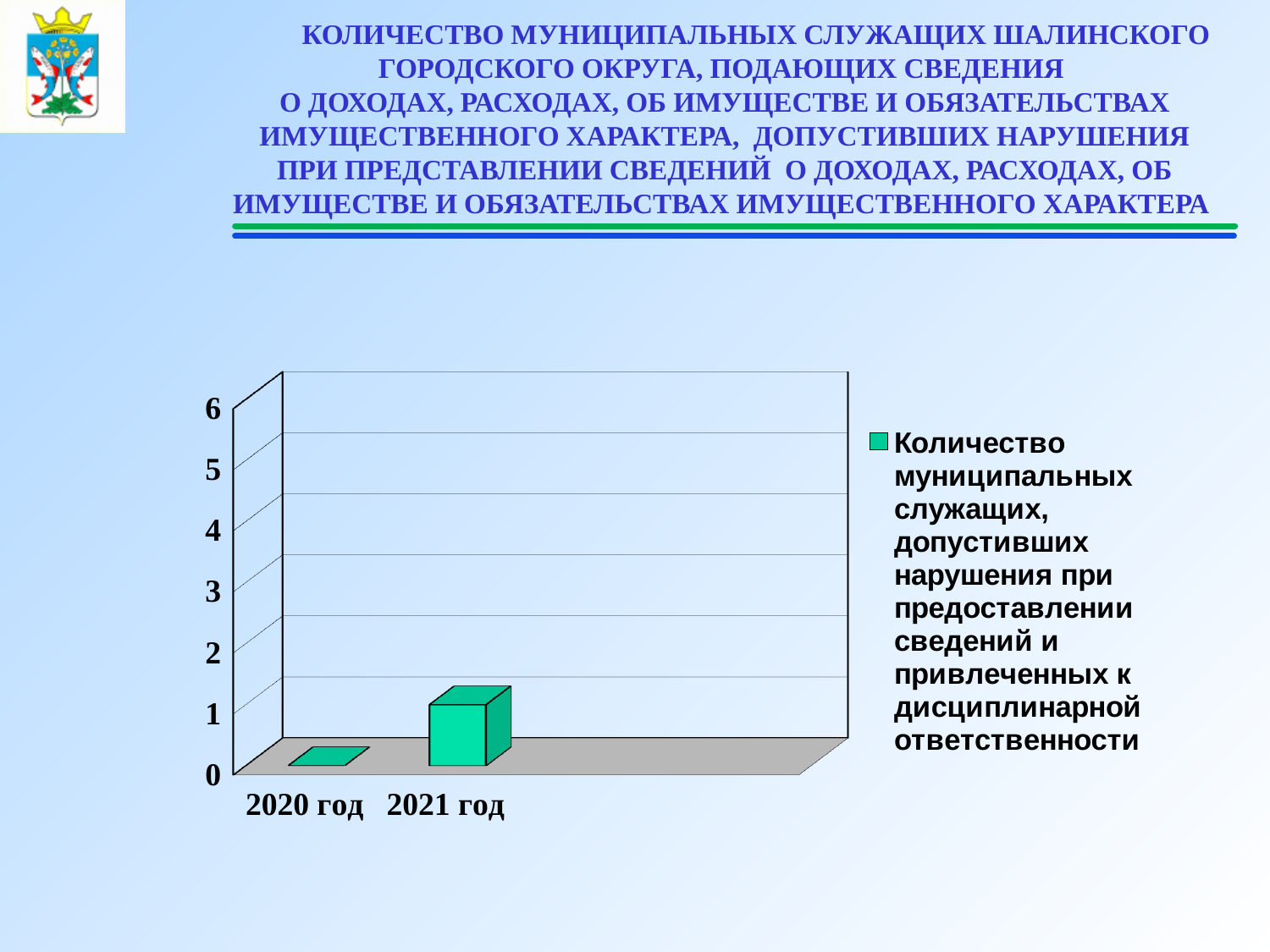
Is the value for 2020 год greater or less than 1? less What is the value for 2020 год in the chart? 0 Is the value for 2021 год greater or less than 2? less What kind of chart is shown on the slide? bar chart Do the values rise or fall from 2020 год to 2021 год? rise What is the value for 2021 год in the chart? 1 What is the highest value shown on the chart's vertical axis? 6 How many categories (years) are shown on the x axis of the chart? 2 How many series does the chart's legend list? 1 Which is larger, the value for 2020 год or the value for 2021 год? 2021 год Which year has the highest value in the chart? 2021 год Which year has the lowest value in the chart? 2020 год